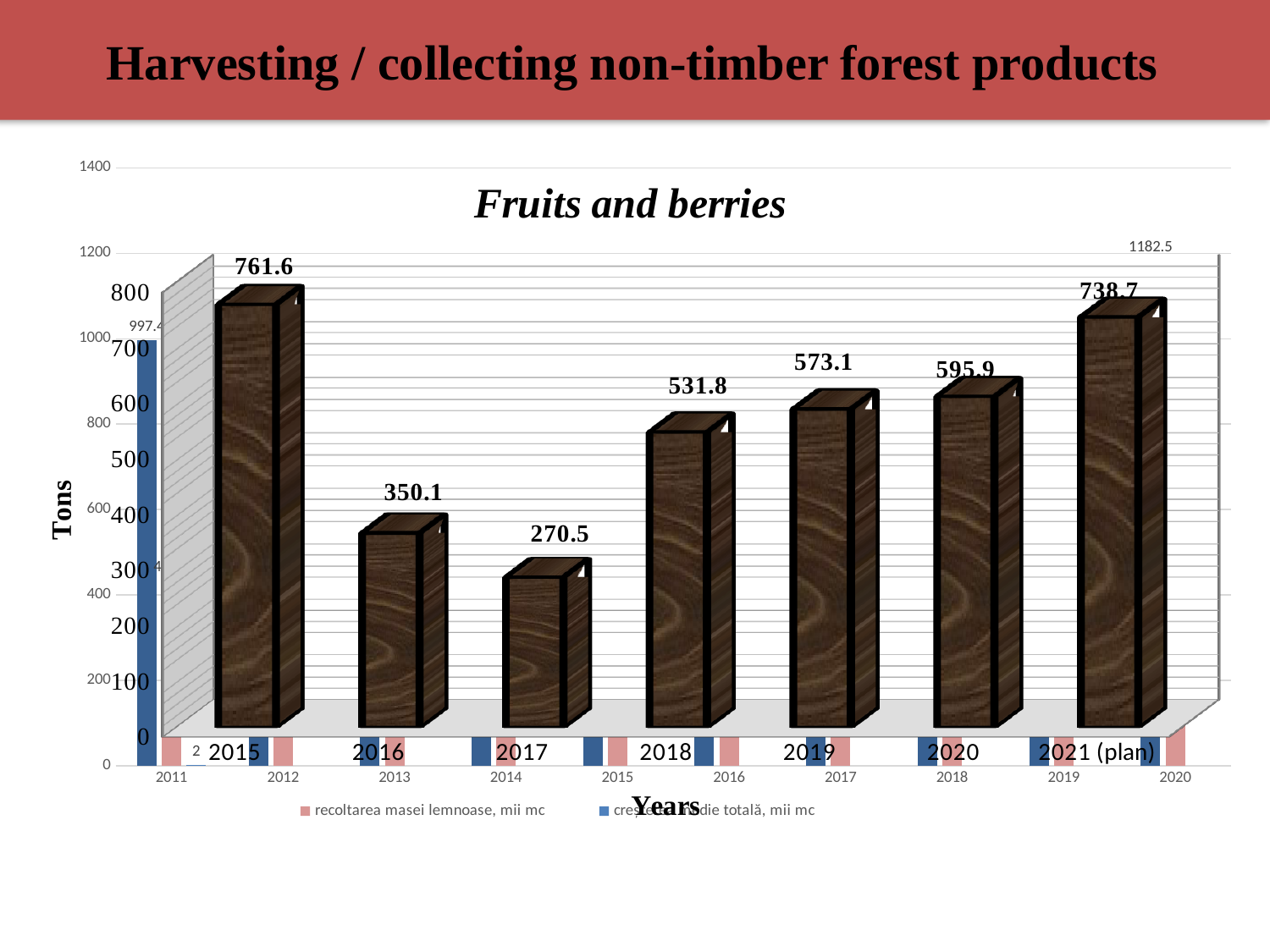
In the Fruits and berries chart, what is the value for 2021 (plan)? 738.7 In the Fruits and berries chart, what is the value for 2017? 270.5 In the Fruits and berries chart, what is the difference between the values for 2015 and 2017? 491.1 In the Fruits and berries chart, do the values rise or fall from 2018 to 2020? rise In the Fruits and berries chart, what is the value for 2015? 761.6 What kind of chart is the Fruits and berries chart? bar chart What is the title of the vertical axis of the Fruits and berries chart? Tons In the Fruits and berries chart, which year has the lowest value? 2017 How many years are shown in the Fruits and berries chart? 7 In the Fruits and berries chart, what is the difference between the values for 2021 (plan) and 2020? 142.8 In the Fruits and berries chart, which is larger, the value for 2019 or the value for 2020? 2020 In the Fruits and berries chart, which year has the highest value? 2015